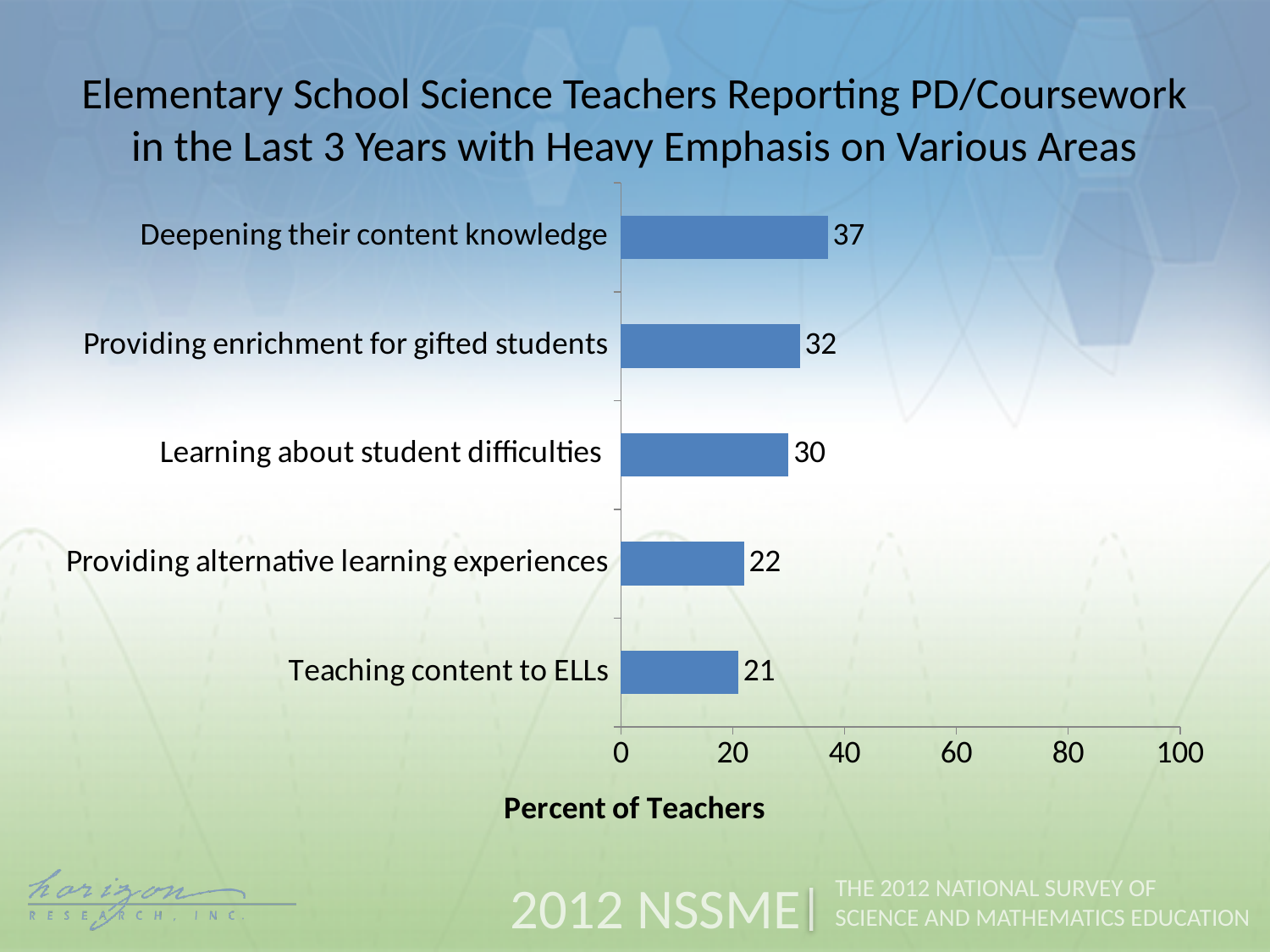
Which area has the highest percent of teachers? Deepening their content knowledge What is the value for Providing enrichment for gifted students? 32 What is the value for Learning about student difficulties? 30 What percent of teachers reported heavy emphasis on deepening their content knowledge? 37 What is the difference between the values for Deepening their content knowledge and Providing alternative learning experiences? 15 What is the label of the horizontal axis? Percent of Teachers What is the value for Teaching content to ELLs? 21 Which is larger: the value for Providing enrichment for gifted students or the value for Learning about student difficulties? Providing enrichment for gifted students Is the value for Providing alternative learning experiences greater or less than 40? less How many areas are shown in the chart? 5 What kind of chart is shown on the slide? Bar chart Which area has the lowest percent of teachers? Teaching content to ELLs